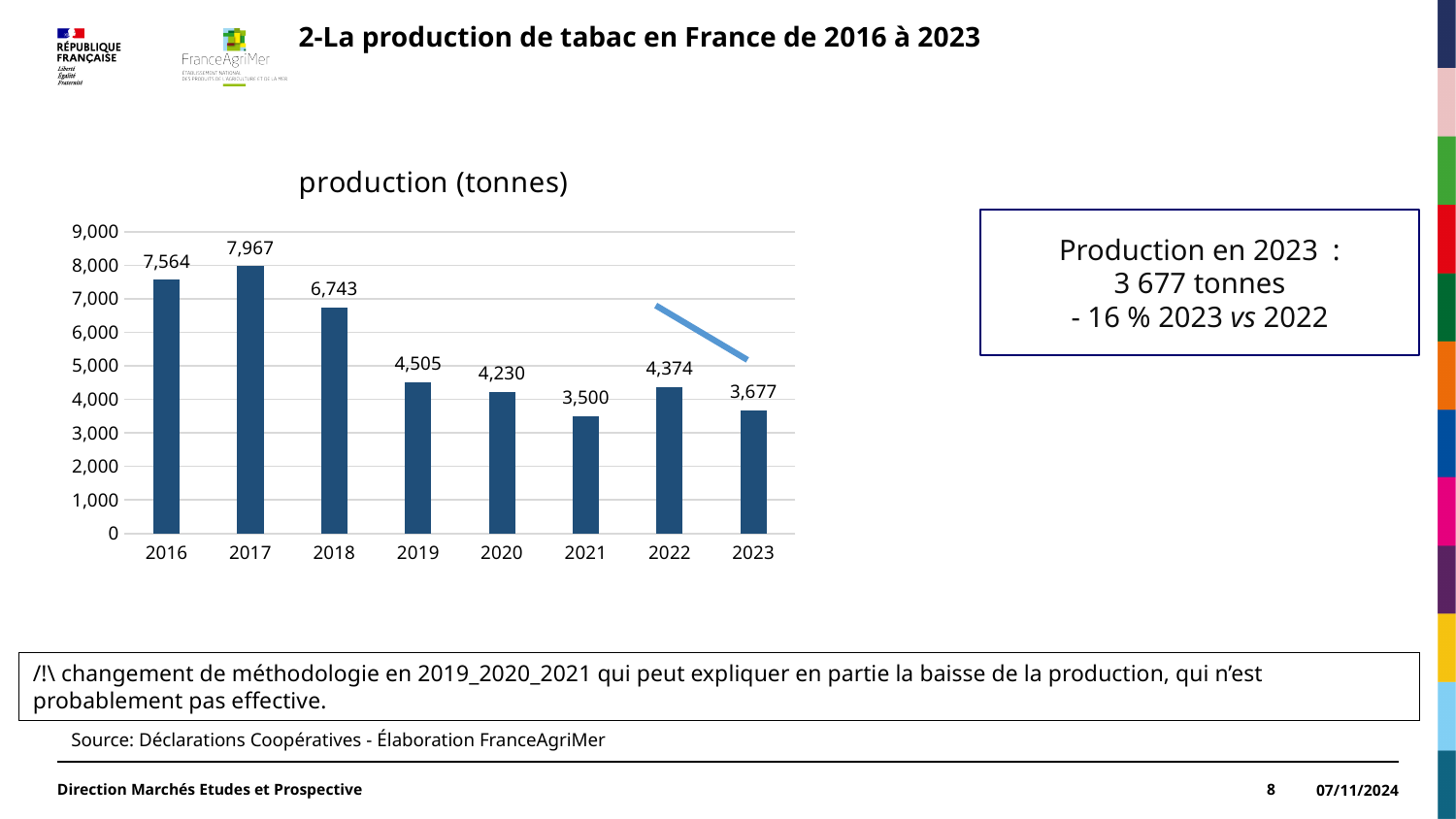
What is the production value for 2023? 3,677 Is the production value for 2018 greater or less than 6,000? greater What is the difference between the production in 2017 and 2016? 403 What kind of chart is shown on the slide? bar chart What is the title of the chart? production (tonnes) What is the production value for 2016? 7,564 What is the production value for 2021? 3,500 Which year has a larger production, 2019 or 2020? 2019 Which year has the lowest production? 2021 Which year has the highest production? 2017 What is the difference between the production in 2022 and 2023? 697 How many years are shown on the x axis? 8